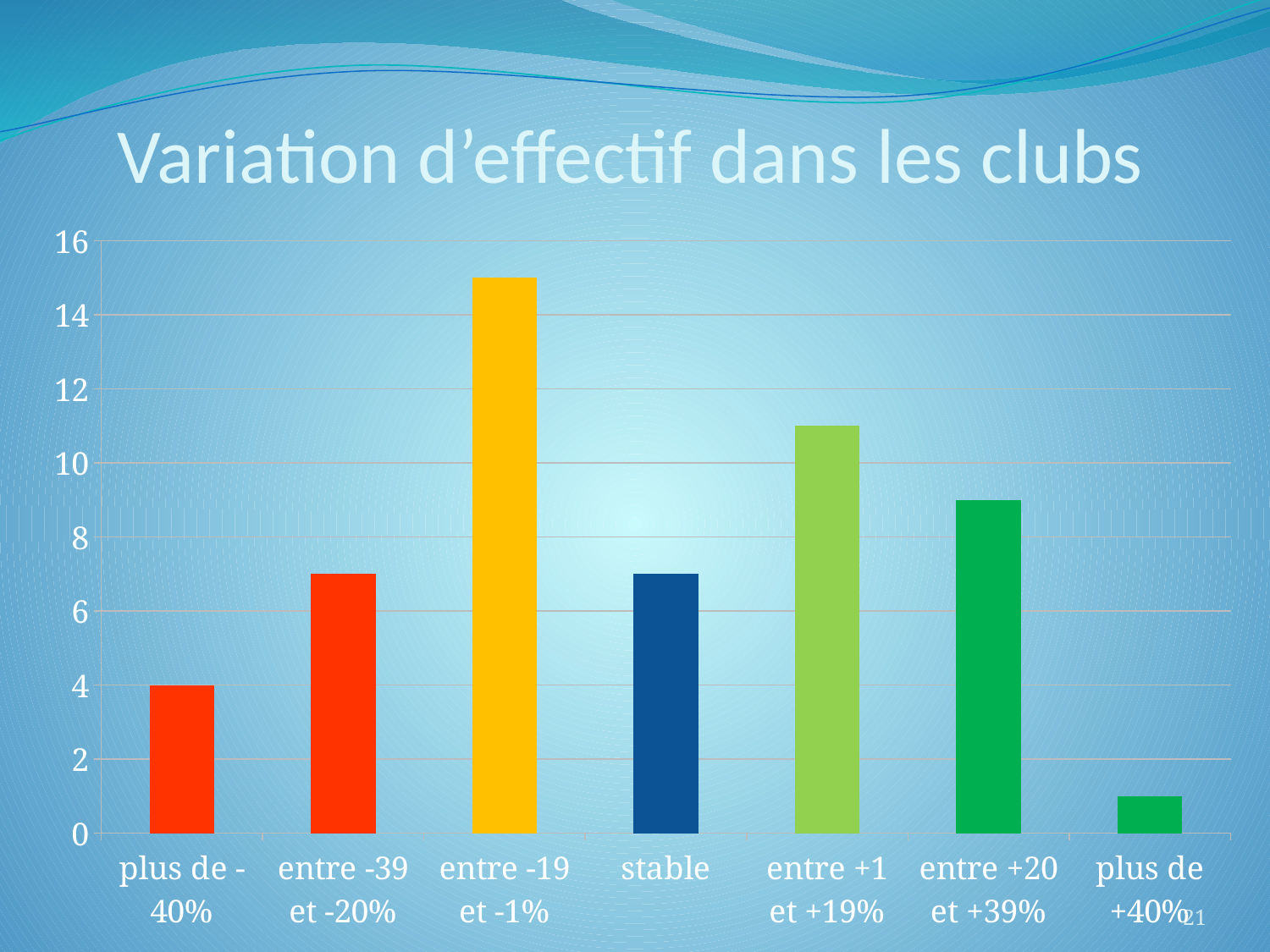
Is the value for 'entre -19 et -1%' greater or less than 14? greater Which category has the highest bar? entre -19 et -1% Is the value for 'stable' greater or less than 6? greater How many categories are shown on the x axis of the chart? 7 Which category has the lowest bar? plus de +40% Which is larger, the value for 'entre +1 et +19%' or the value for 'entre +20 et +39%'? entre +1 et +19% What kind of chart is shown on the slide? bar chart Is the value for 'entre +1 et +19%' greater or less than 10? greater What is the value for 'plus de -40%'? 4 What is the title of the chart? Variation d'effectif dans les clubs